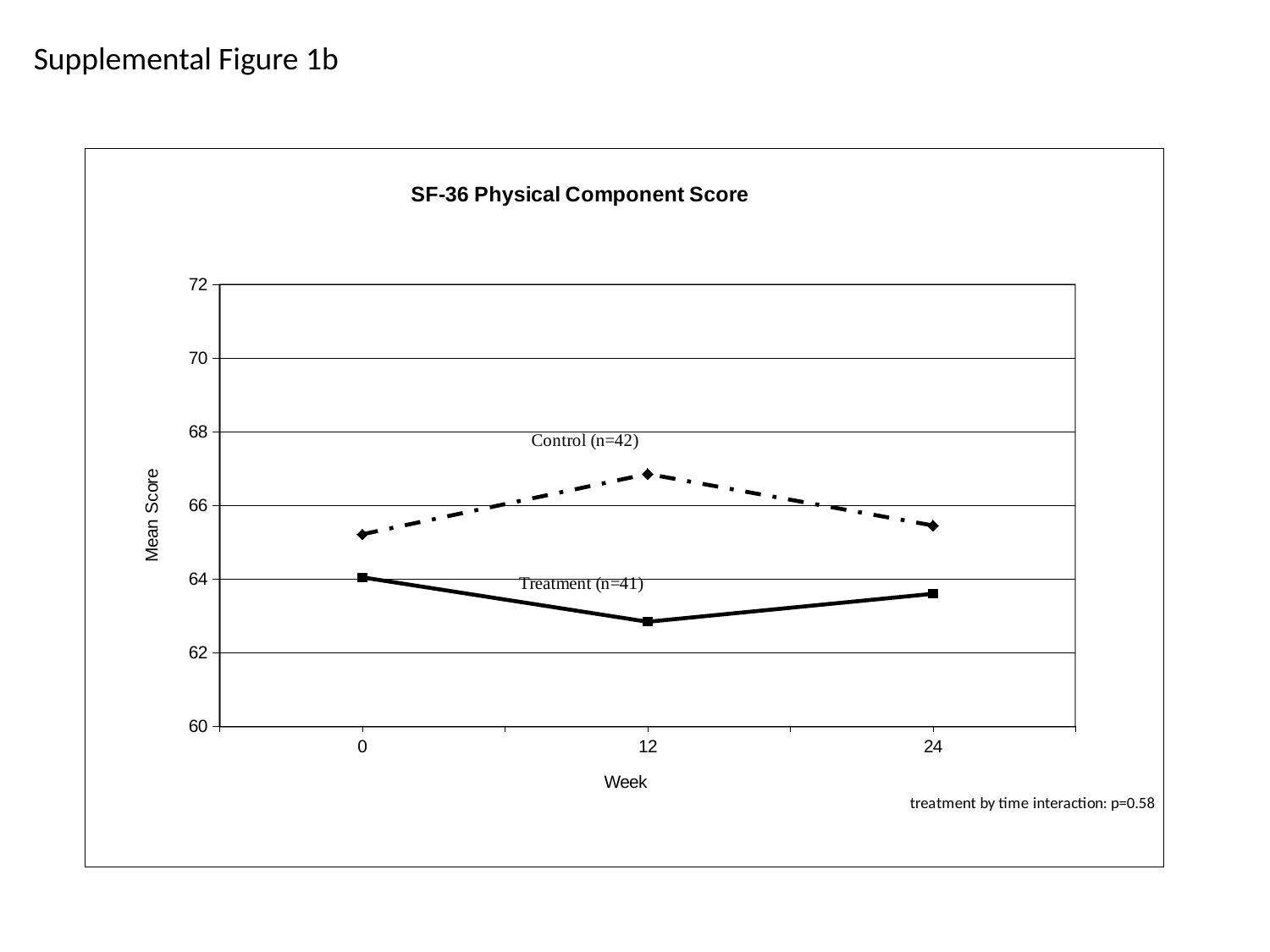
At week 12, which group has the higher mean score, Control or Treatment? Control Is the Treatment (n=41) mean score at week 12 greater or less than 64? less How many series are plotted in the SF-36 Physical Component Score chart? 2 Is the Control (n=42) mean score at week 24 greater or less than 64? greater What p-value is reported for the treatment by time interaction? p=0.58 What kind of chart is shown on the slide? line chart At which week does the Treatment (n=41) series reach its lowest mean score? 12 Is the Control (n=42) mean score at week 12 greater or less than 66? greater At which week does the Control (n=42) series reach its highest mean score? 12 Does the Treatment (n=41) mean score rise or fall from week 0 to week 12? fall How many time points (weeks) are plotted along the x axis? 3